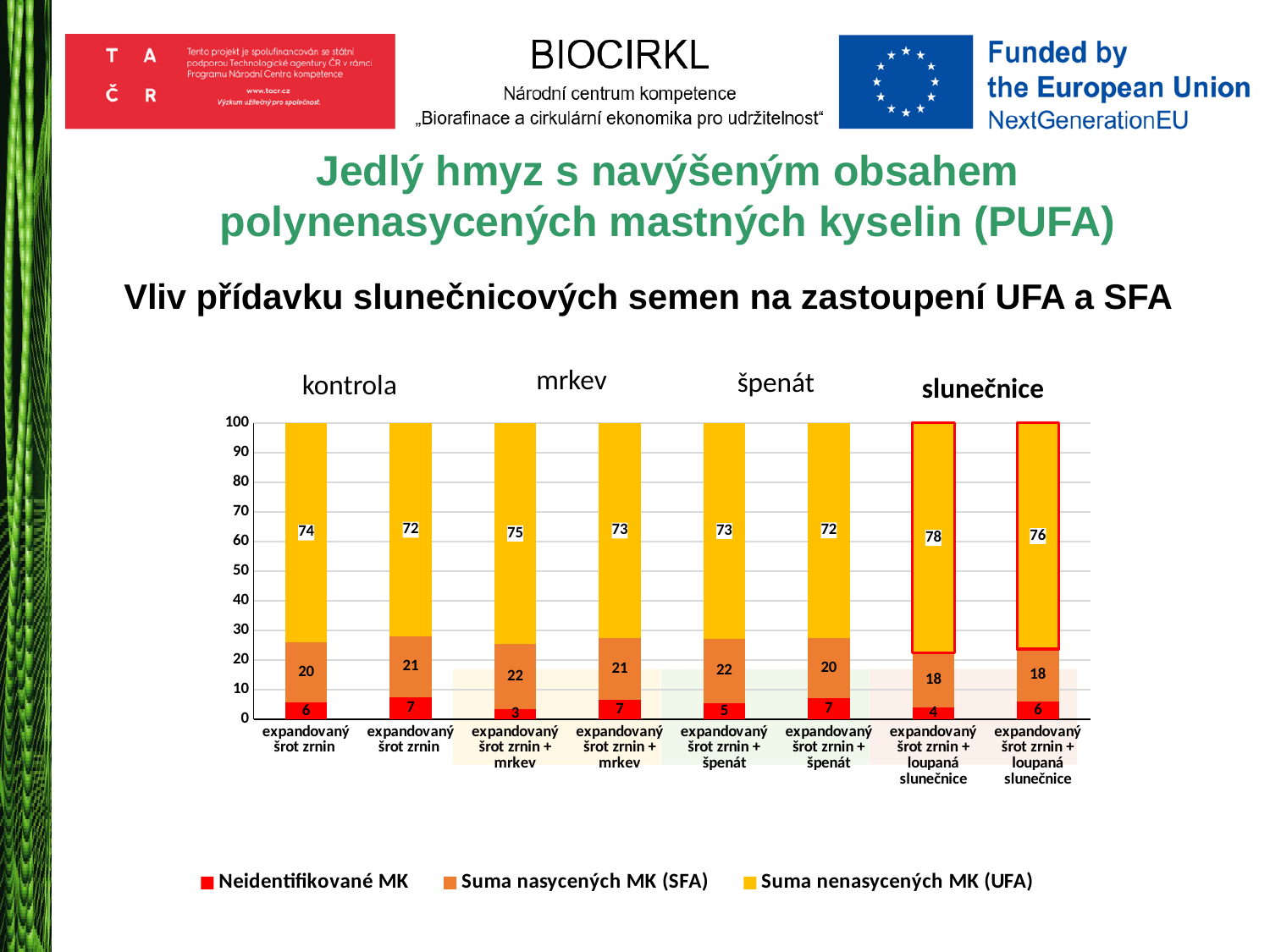
How many series does the chart legend list? 3 Which bar has the highest value for Suma nenasycených MK (UFA)? the first bar in the slunečnice group (expandovaný šrot zrnin + loupaná slunečnice) What is the difference in Suma nenasycených MK (UFA) between the first slunečnice bar and the first kontrola bar? 4 What is the total of the stacked segments for the second bar in the špenát group? 99 How many bars are plotted in the chart? 8 What is the value of Neidentifikované MK for the second bar in the kontrola group? 7 Which is larger: the Suma nasycených MK (SFA) value for the first kontrola bar or for the first slunečnice bar? the first kontrola bar (20) Which bar has the lowest value for Neidentifikované MK? the first bar in the mrkev group (expandovaný šrot zrnin + mrkev) What is the value of Suma nasycených MK (SFA) for the first bar in the mrkev group? 22 What is the value of Suma nenasycených MK (UFA) for the first bar in the slunečnice group? 78 What type of chart is shown on the slide? stacked bar chart Which series is shown in yellow in the chart? Suma nenasycených MK (UFA)